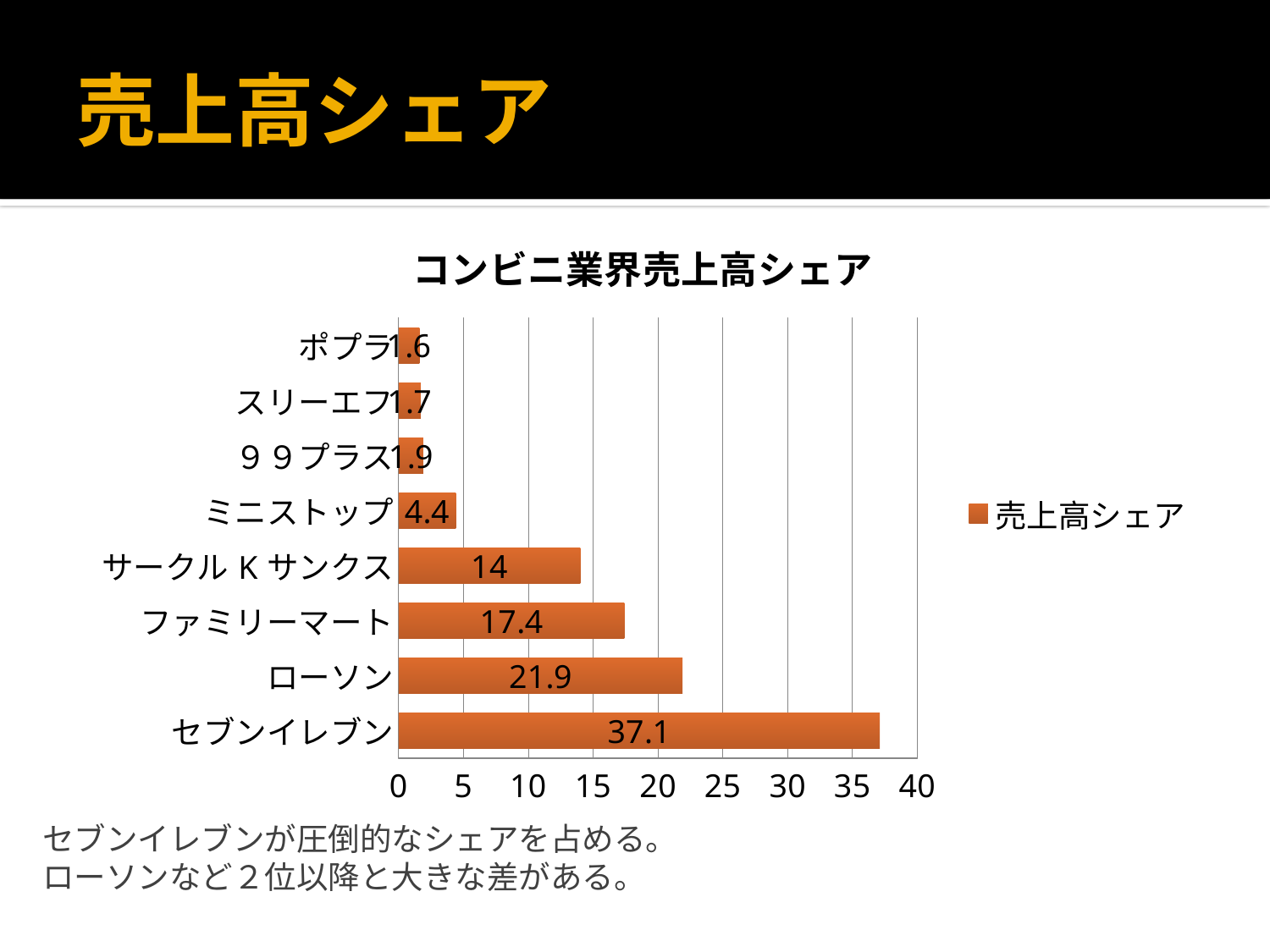
Which category has the highest value? セブンイレブン What is the value for セブンイレブン? 37.1 Which is larger, the value for サークルKサンクス or the value for ファミリーマート? ファミリーマート How many categories are shown in the chart? 8 What is the value for ローソン? 21.9 Which category has the lowest value? ポプラ What is the title of the chart? コンビニ業界売上高シェア What is the value for ファミリーマート? 17.4 Is the value for ローソン greater or less than 20? greater What is the value for ミニストップ? 4.4 What kind of chart is shown on the slide? bar chart What is the difference between the values for セブンイレブン and ローソン? 15.2